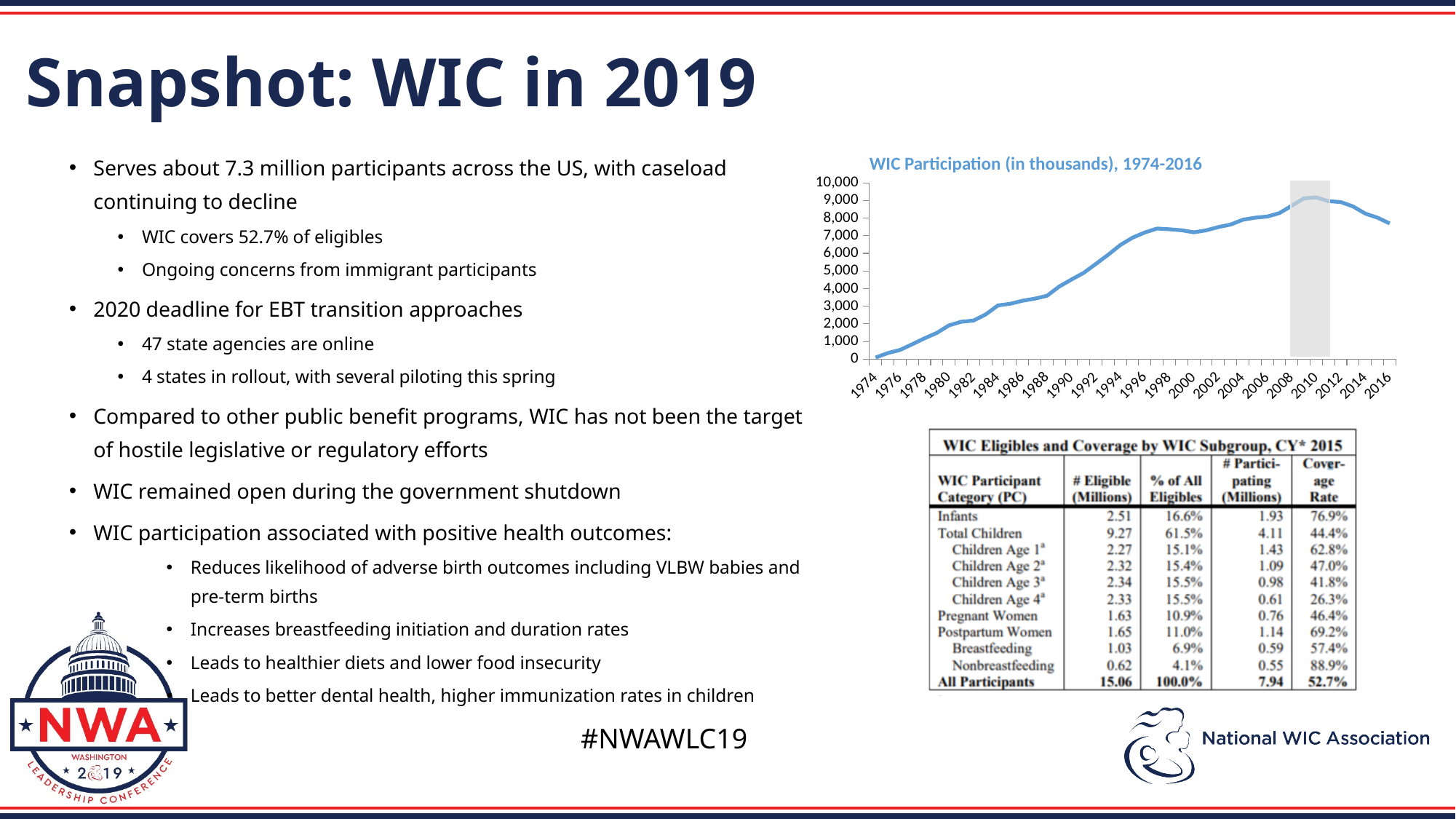
How many year labels are shown on the x axis of the WIC Participation chart? 22 In the WIC Participation chart, which year has the larger value, 2010 or 2016? 2010 What kind of chart is shown on the slide? line chart In the WIC Participation chart, is the value for 1990 greater or less than 4,000? greater In the WIC Participation chart, is the value for 1988 greater or less than 4,000? less In the WIC Participation chart, is the value for 1974 greater or less than 1,000? less What is the title of the chart on the slide? WIC Participation (in thousands), 1974-2016 In the WIC Participation chart, do the values rise or fall between 2010 and 2016? fall In the WIC Participation chart, which year has the larger value, 1974 or 2016? 2016 In the WIC Participation chart, do the values rise or fall between 1974 and 1996? rise